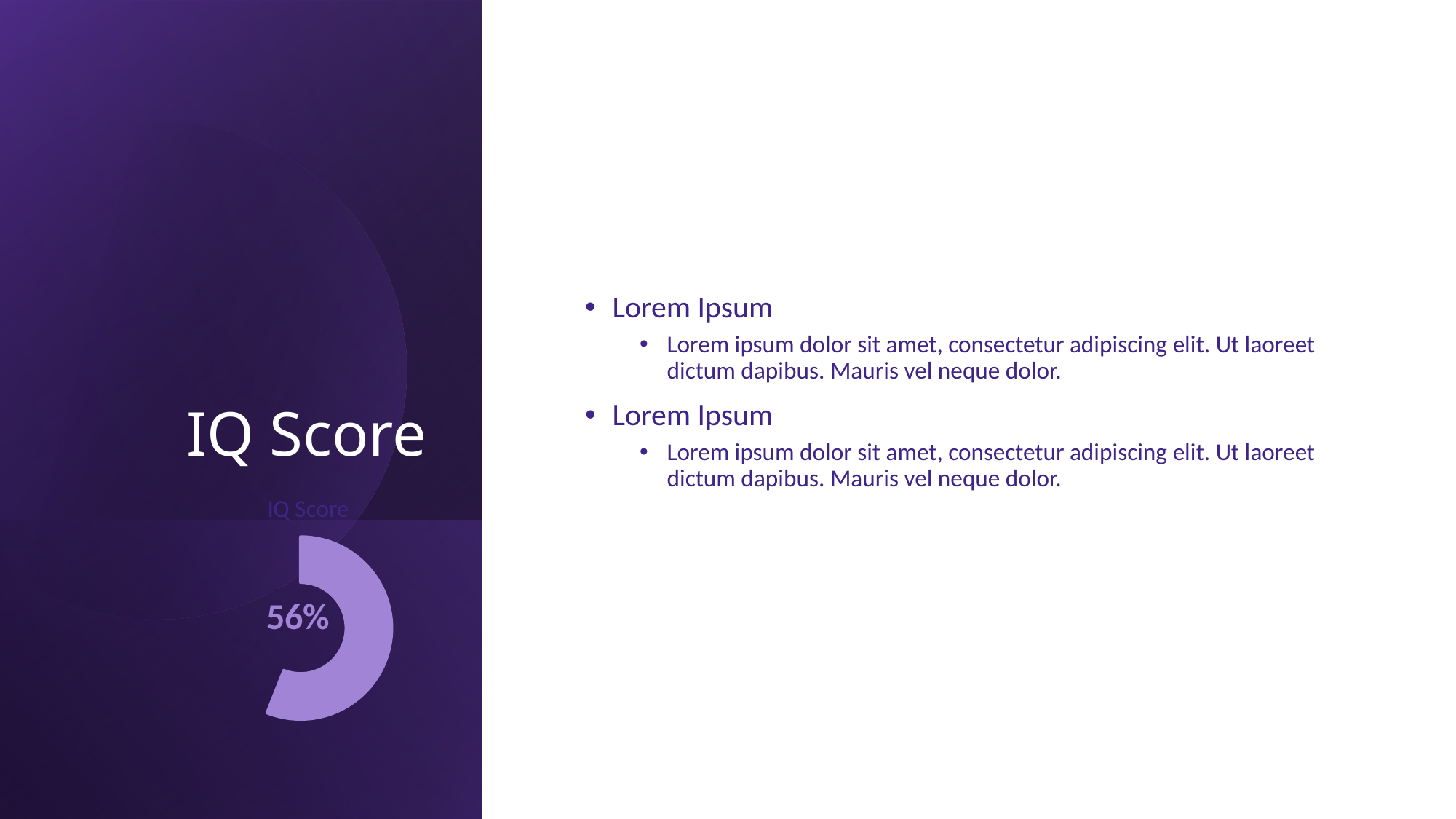
What is the chart's title? IQ Score Is the highlighted slice of the IQ Score chart more or less than half of the doughnut? more What kind of chart is shown on the slide? doughnut chart What share of the IQ Score doughnut does the highlighted slice represent? 56% What percentage is printed on the IQ Score doughnut chart? 56% What colour is the highlighted slice of the IQ Score doughnut chart? light purple